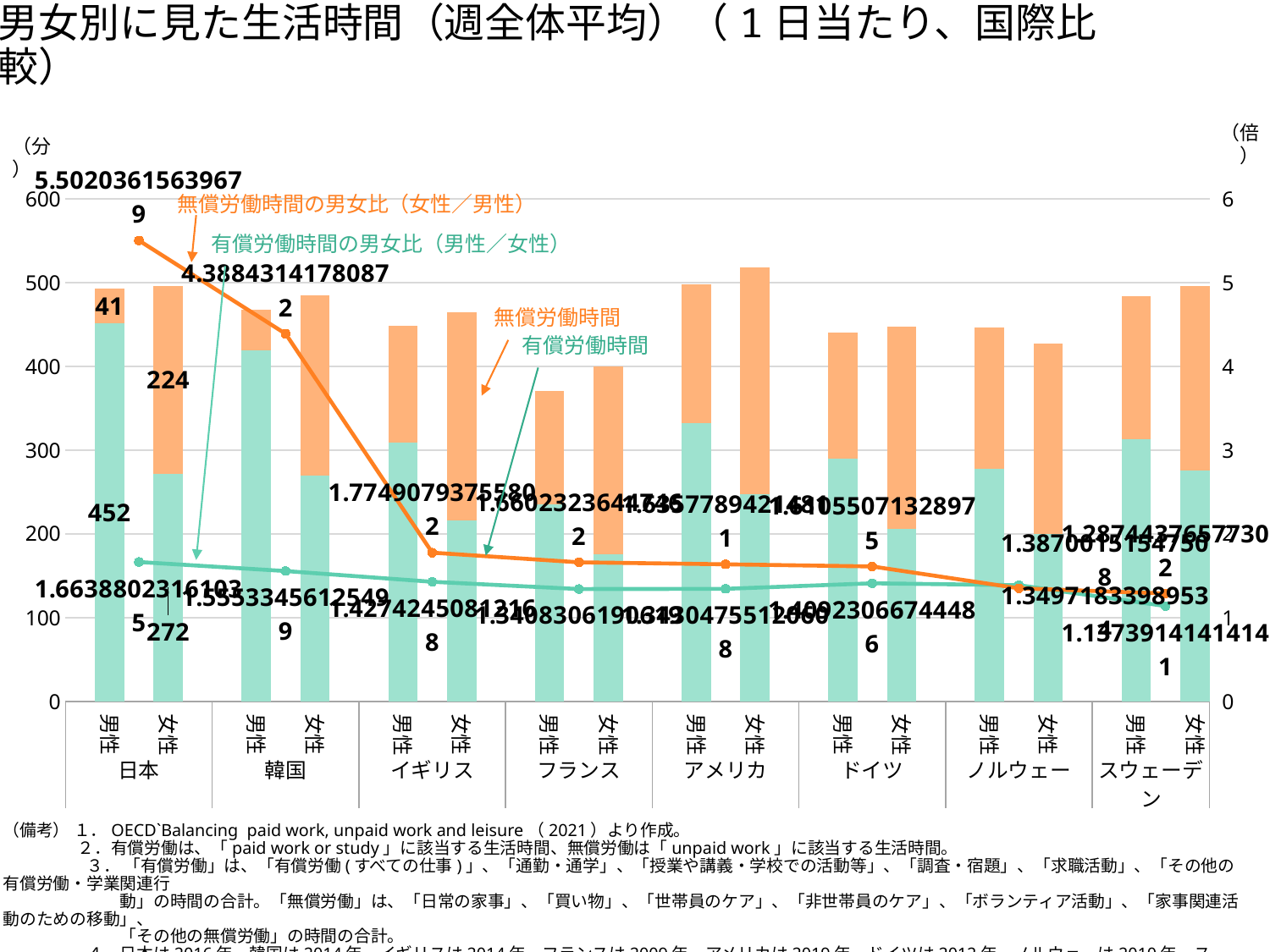
What is the 有償労働時間 value for 日本 女性? 272 What is the 無償労働時間 value for 日本 男性? 41 Is the 有償労働時間 value for 韓国 女性 greater or less than 300? less What kind of chart is shown on the slide? combination bar and line chart (stacked bars with lines) What is the 有償労働時間 value for 日本 男性? 452 How many countries are shown on the x axis? 8 What is the total of the stacked bar for 日本 女性? 496 Does the 無償労働時間の男女比（女性／男性） line rise or fall from 日本 to スウェーデン? fall Which has the larger 有償労働時間 value, 日本 男性 or 日本 女性? 日本 男性 What is the difference between the 有償労働時間 values for 日本 男性 and 日本 女性? 180 What is the 無償労働時間 value for 日本 女性? 224 What unit is shown on the right-hand axis? 倍